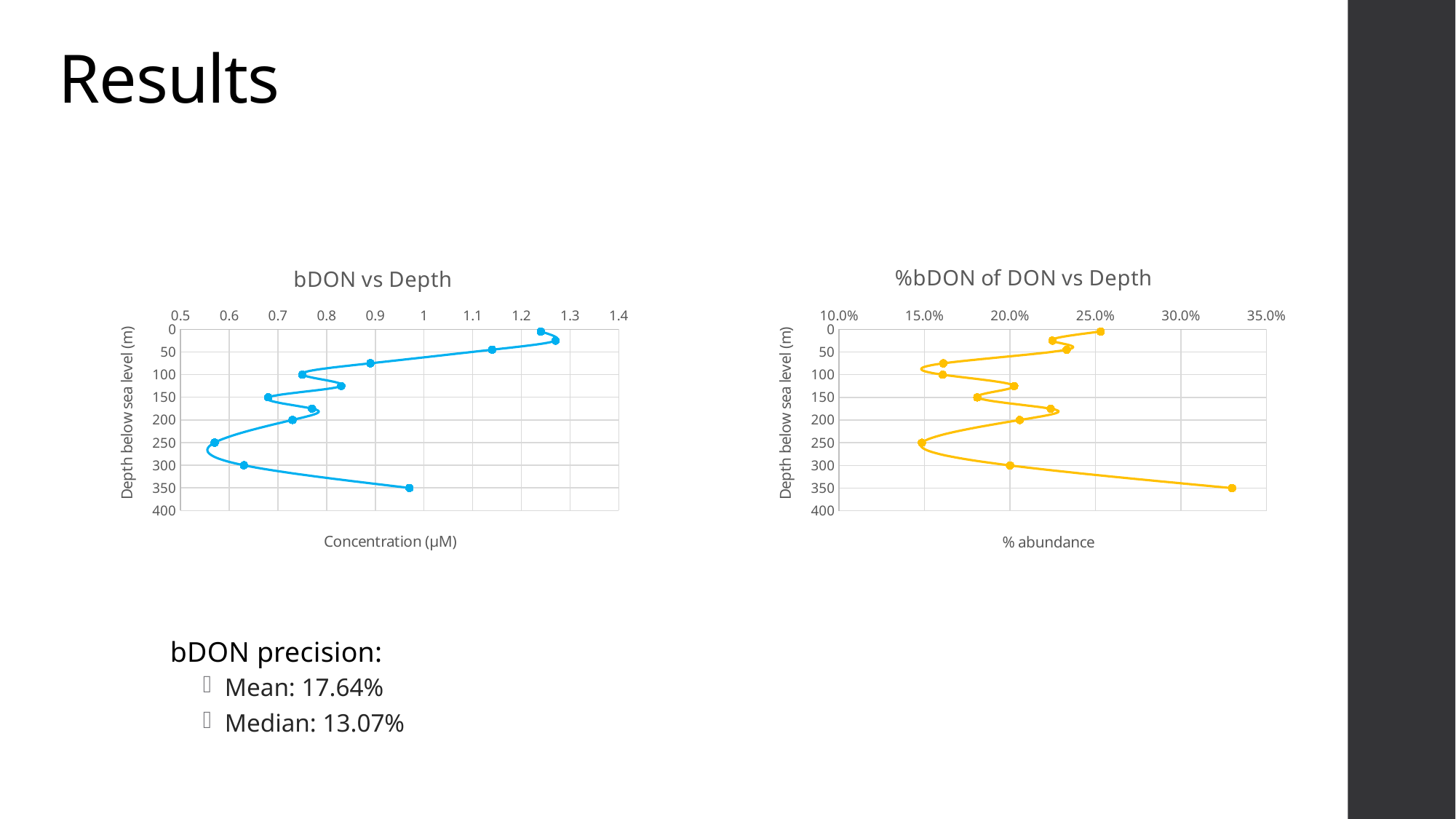
What is the x-axis label of the 'bDON vs Depth' chart? Concentration (µM) On the '%bDON of DON vs Depth' chart, at which depth is the % abundance highest? 350 m On the '%bDON of DON vs Depth' chart, is the % abundance at 350 m greater or less than 30.0%? greater On the '%bDON of DON vs Depth' chart, at which depth is the % abundance lowest? 250 m On the 'bDON vs Depth' chart, is the concentration at 250 m greater or less than 0.6? less On the 'bDON vs Depth' chart, which has the higher concentration: 25 m or 300 m? 25 m How many data points are plotted on the '%bDON of DON vs Depth' chart? 12 What is the x-axis label of the '%bDON of DON vs Depth' chart? % abundance On the 'bDON vs Depth' chart, is the concentration at 45 m greater or less than 1.1? greater On the 'bDON vs Depth' chart, at which depth is the concentration lowest? 250 m What kind of chart is the 'bDON vs Depth' chart? Scatter chart with a smoothed line How many data points are plotted on the 'bDON vs Depth' chart? 12